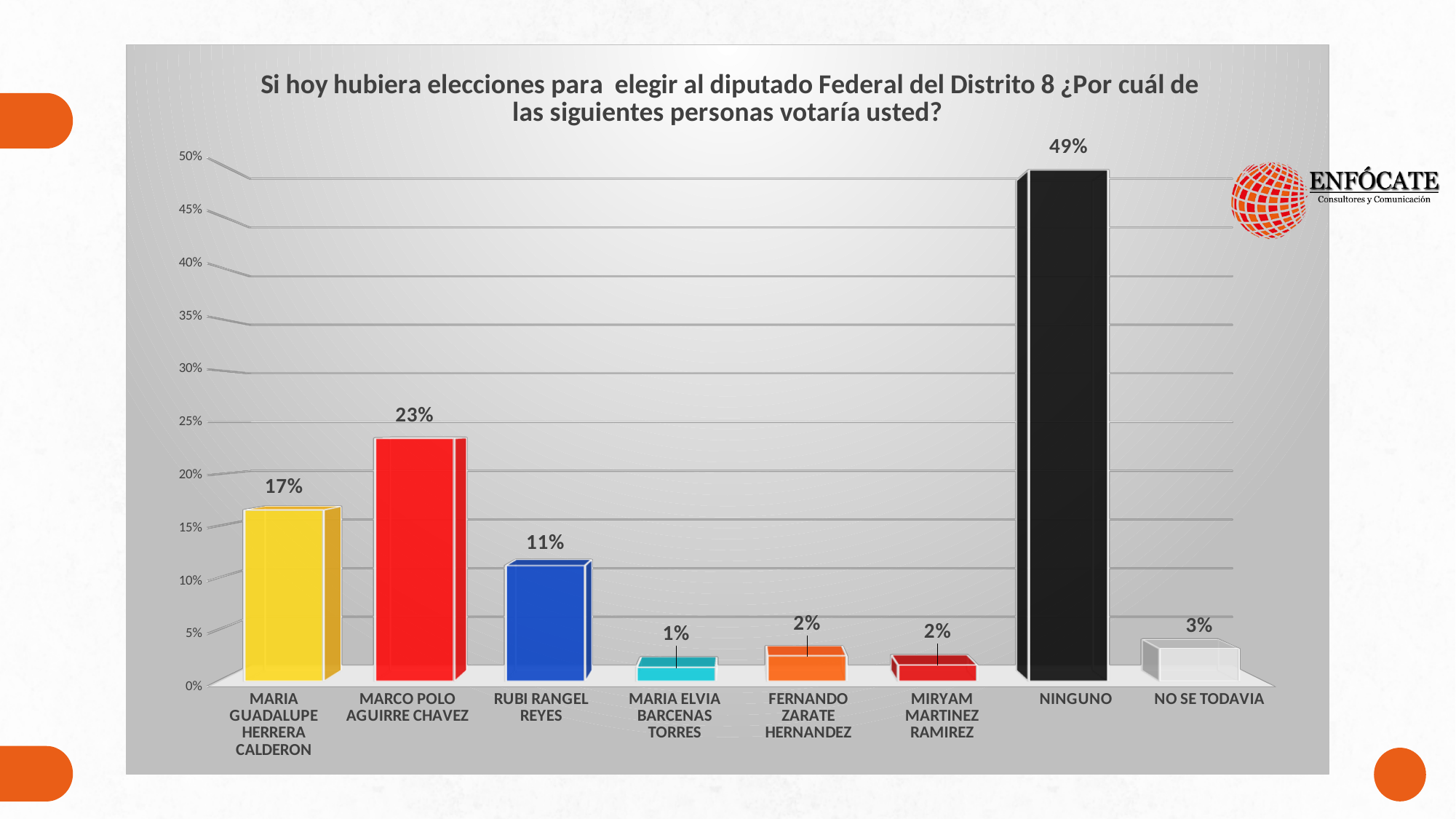
Which category has the highest value? NINGUNO What percentage is shown for RUBI RANGEL REYES? 11% How many categories are shown on the x axis? 8 Is the value for NINGUNO greater or less than 45%? greater Which category has the lowest value? MARIA ELVIA BARCENAS TORRES What colour is the bar for NINGUNO? black What percentage is shown for NINGUNO? 49% What percentage is shown for NO SE TODAVIA? 3% Which is larger, the value for MARIA GUADALUPE HERRERA CALDERON or the value for RUBI RANGEL REYES? MARIA GUADALUPE HERRERA CALDERON What is the difference between the values for MARCO POLO AGUIRRE CHAVEZ and MARIA GUADALUPE HERRERA CALDERON? 6% What percentage is shown for MARCO POLO AGUIRRE CHAVEZ? 23% What kind of chart is shown on the slide? bar chart